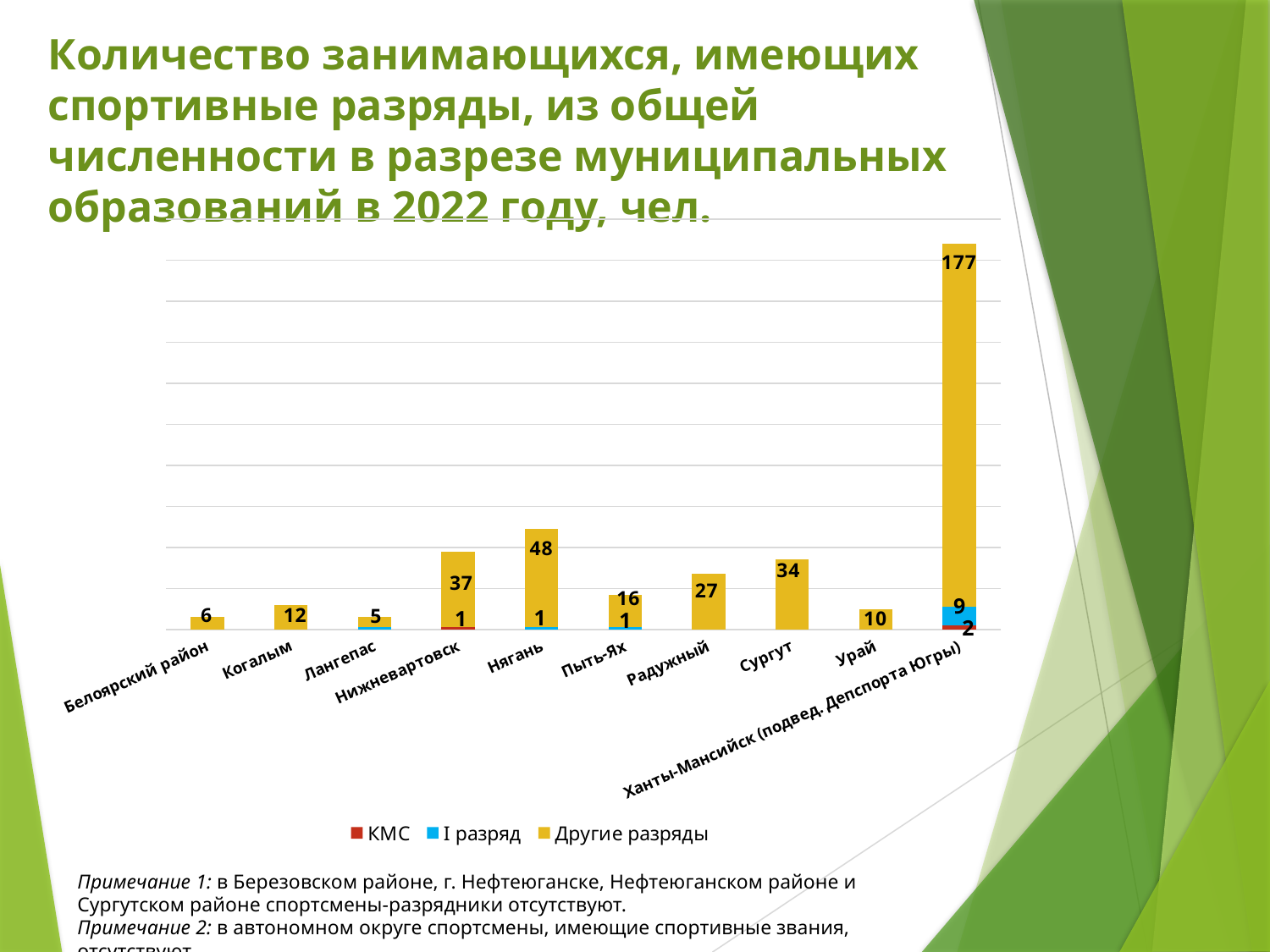
Which municipality has the highest value of Другие разряды? Ханты-Мансийск (подвед. Депспорта Югры) Which has a larger Другие разряды value, Радужный or Урай? Радужный How many municipalities are shown on the x axis? 10 What is the total of the stacked bar for Ханты-Мансийск (подвед. Депспорта Югры)? 188 What is the value of I разряд for Ханты-Мансийск (подвед. Депспорта Югры)? 9 Which municipality has the lowest value of Другие разряды? Лангепас How many series does the legend list? 3 What colour represents the Другие разряды series in the legend? yellow What is the difference between the Другие разряды values for Нягань and Нижневартовск? 11 What type of chart is shown on the slide? bar chart What is the value of КМС for Ханты-Мансийск (подвед. Депспорта Югры)? 2 What is the value of Другие разряды for Сургут? 34